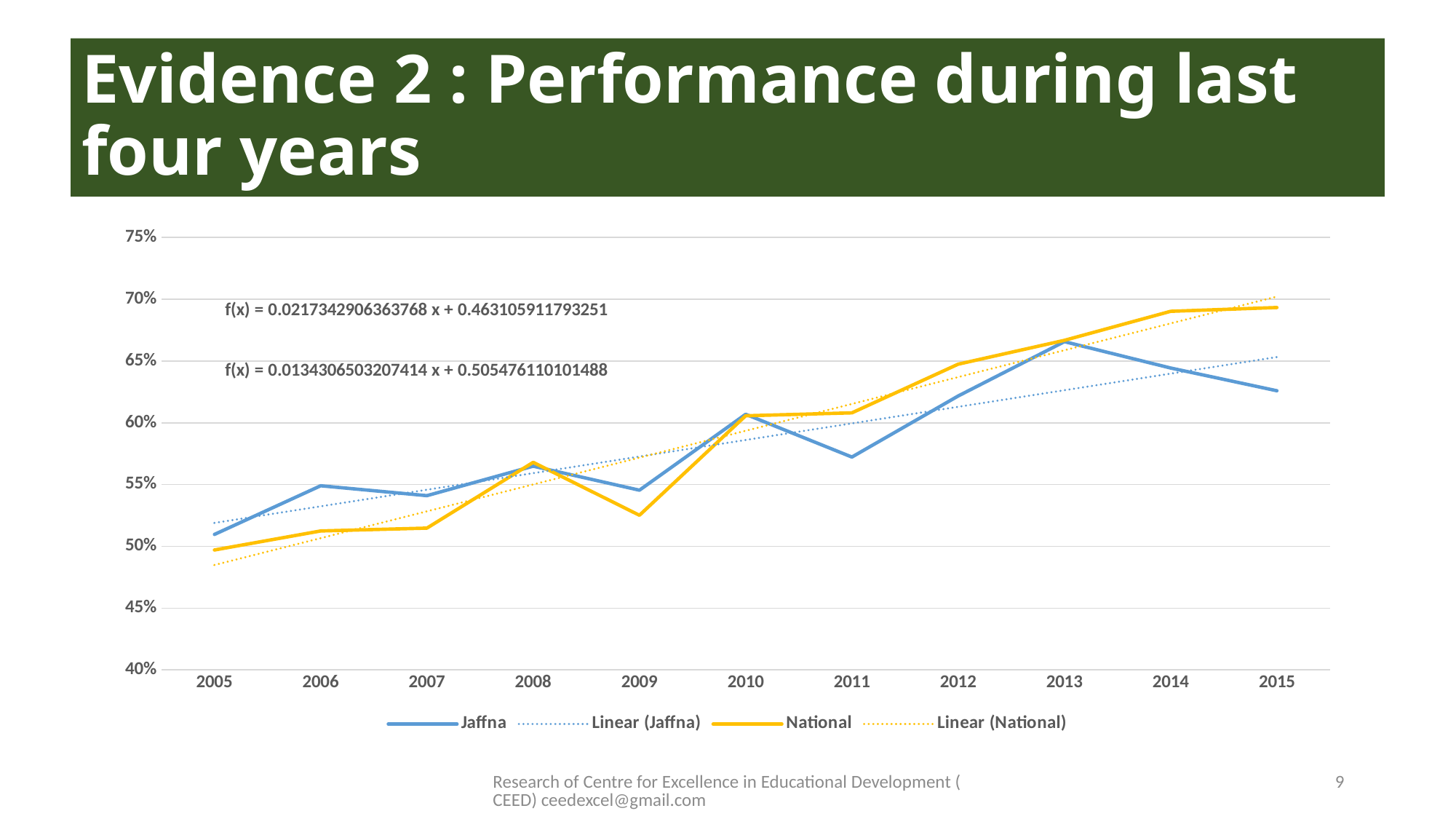
How many series does the legend list? 4 In which year does the Jaffna series reach its highest value? 2013 Does the National series generally rise or fall from 2005 to 2015? rise In which year is the National series at its lowest value? 2005 In 2006, which series has the higher value, Jaffna or National? Jaffna In which year is the Jaffna series at its lowest value? 2005 Is the value for National in 2009 greater or less than 55%? less In 2015, which series has the higher value, Jaffna or National? National Is the value for National in 2014 greater or less than 65%? greater What is the first legend entry shown below the chart? Jaffna How many years are plotted along the x axis? 11 What kind of chart is shown on the slide? Line chart